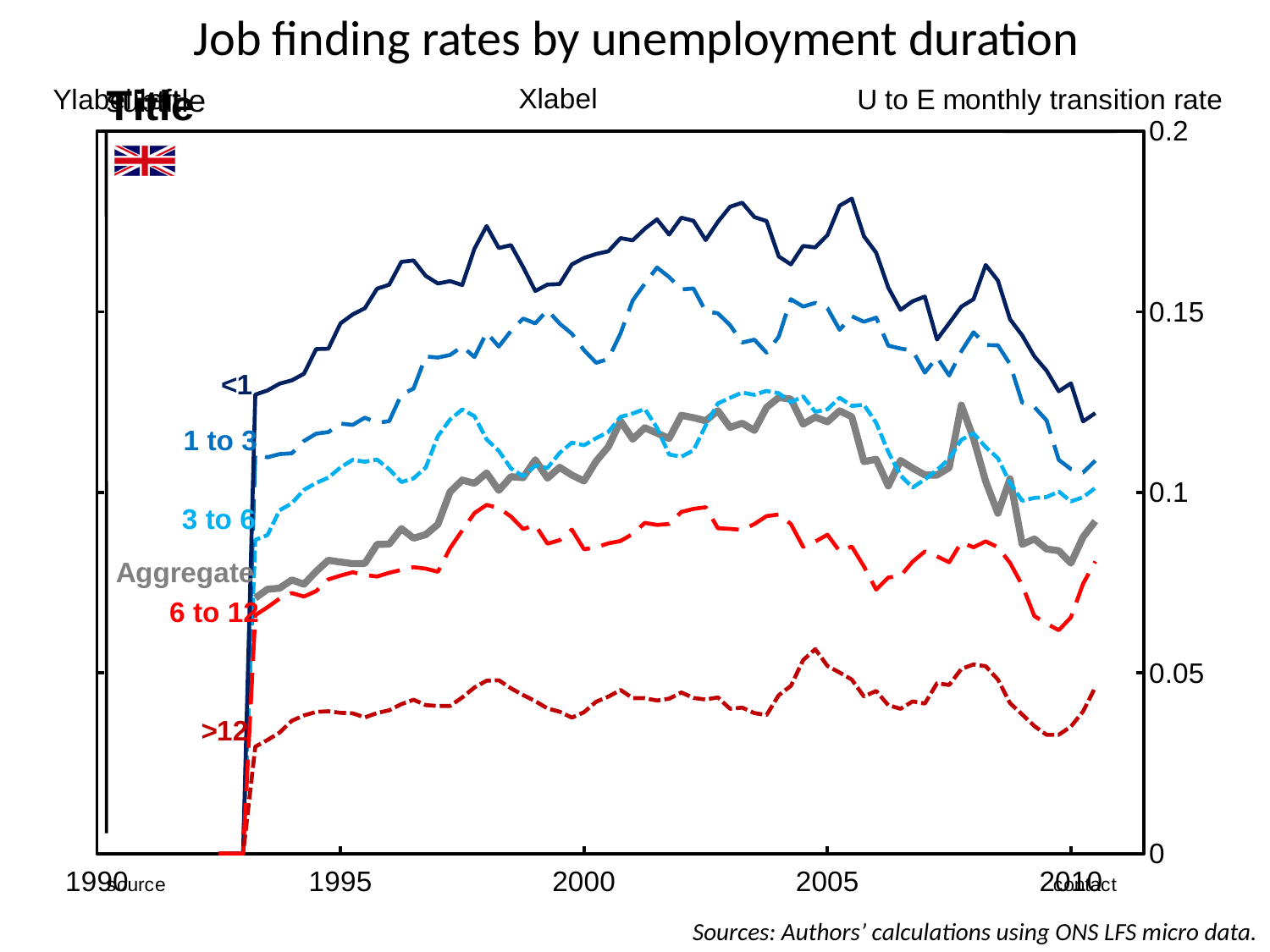
Does the <1 series rise or fall between 2008 and 2010? fall Is the value for the <1 series in 2005 greater or less than 0.15? greater Which series has the lowest values across the chart? >12 Which is larger in 2000, the Aggregate series or the 6 to 12 series? Aggregate What is the title of the chart? Job finding rates by unemployment duration What kind of chart is shown on the slide? line chart Is the value for the >12 series in 2000 greater or less than 0.05? less Which series has the highest values across the chart? <1 How many series are labelled on the chart? 6 What label is given to the vertical axis? U to E monthly transition rate Is the value for the Aggregate series in 2004 greater or less than 0.1? greater